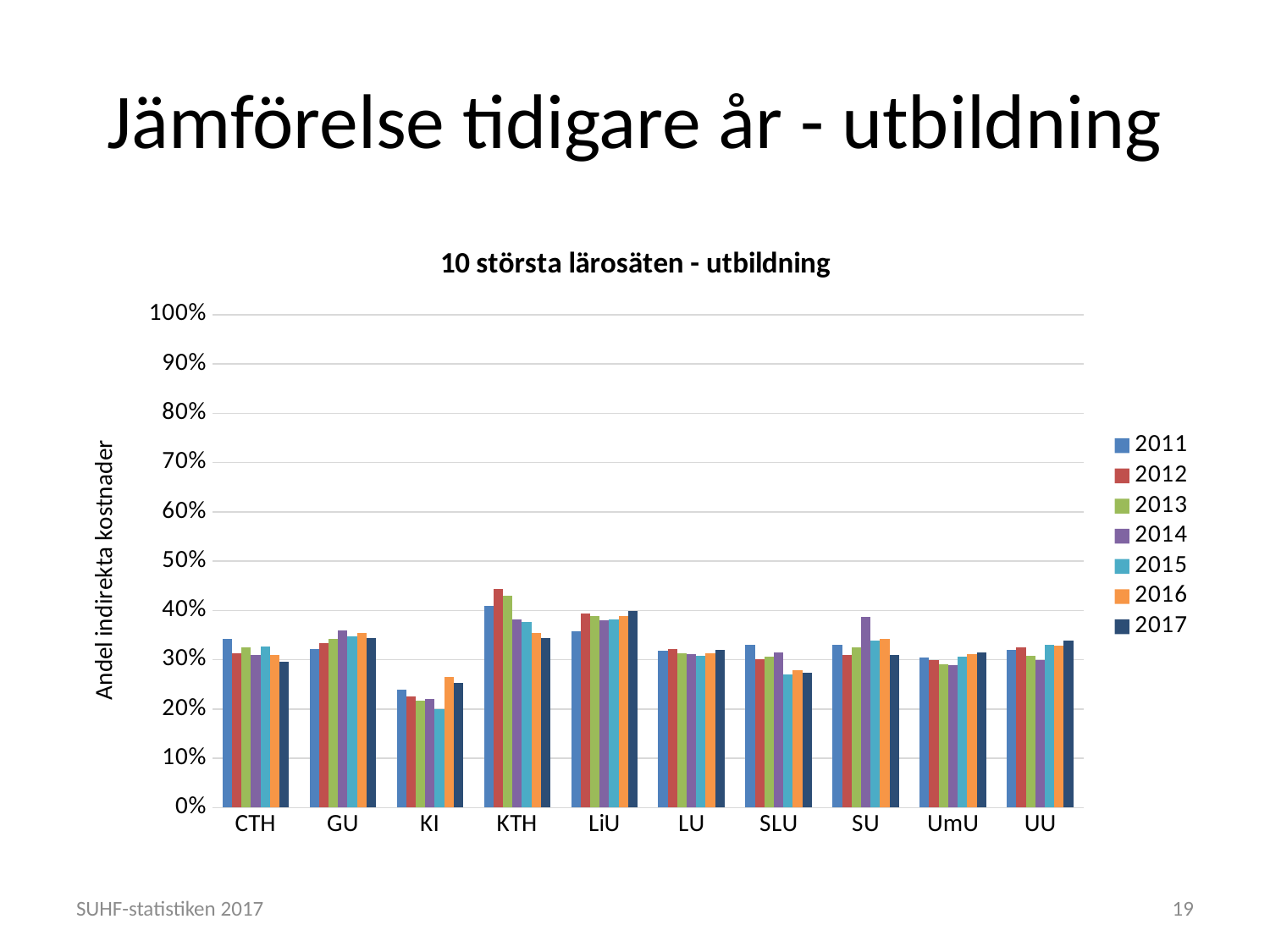
Which institution has the lowest value for 2015? KI Is the 2012 value for KTH greater or less than 40%? greater How many series does the legend list? 7 What is the title of the chart? 10 största lärosäten - utbildning Which institution has the highest value for 2012? KTH From 2012 to 2017, do the values for KTH rise or fall? fall Is the 2014 value for SU greater or less than 35%? greater Is the 2015 value for KI greater or less than 30%? less For SU, which year has the highest value? 2014 What kind of chart is shown on the slide? Bar chart Which is larger, the 2011 value for KTH or the 2011 value for KI? KTH How many institutions (categories) are shown on the x axis? 10